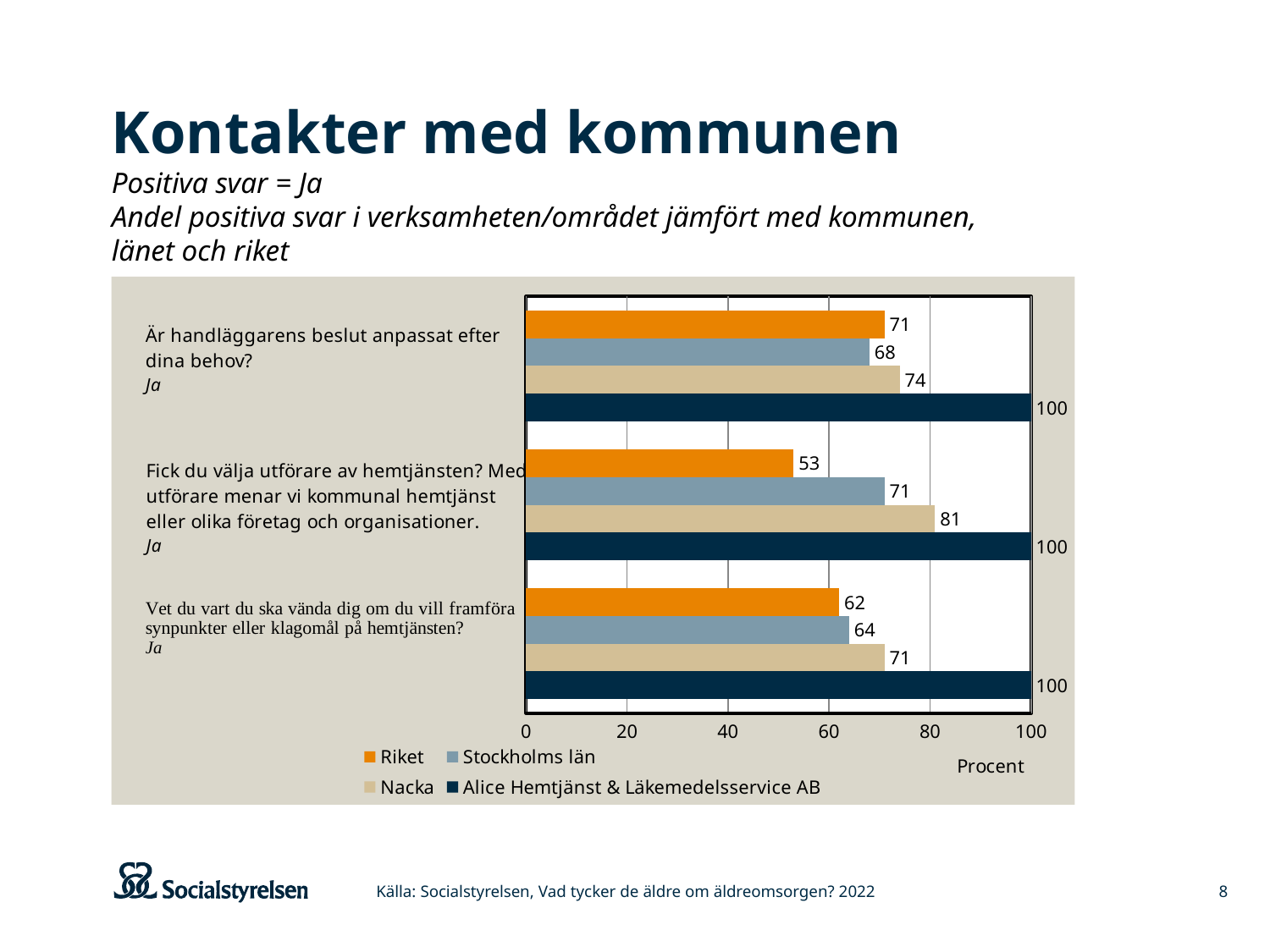
What is the value for Riket on the question "Fick du välja utförare av hemtjänsten?"? 53 What kind of chart is shown on the slide? Bar chart How many question categories are shown on the chart? 3 What is the value for Alice Hemtjänst & Läkemedelsservice AB on the question "Fick du välja utförare av hemtjänsten?"? 100 Which series has the lowest value on the question "Fick du välja utförare av hemtjänsten?"? Riket What is the value for Stockholms län on the question "Vet du vart du ska vända dig om du vill framföra synpunkter eller klagomål på hemtjänsten?"? 64 Which series has the highest value on the question "Är handläggarens beslut anpassat efter dina behov?"? Alice Hemtjänst & Läkemedelsservice AB How many series does the legend list? 4 What is the difference between Nacka and Stockholms län on the question "Vet du vart du ska vända dig om du vill framföra synpunkter eller klagomål på hemtjänsten?"? 7 What is the difference between Nacka and Riket on the question "Fick du välja utförare av hemtjänsten?"? 28 What is the value for Nacka on the question "Är handläggarens beslut anpassat efter dina behov?"? 74 Which is larger on the question "Är handläggarens beslut anpassat efter dina behov?": Riket or Stockholms län? Riket